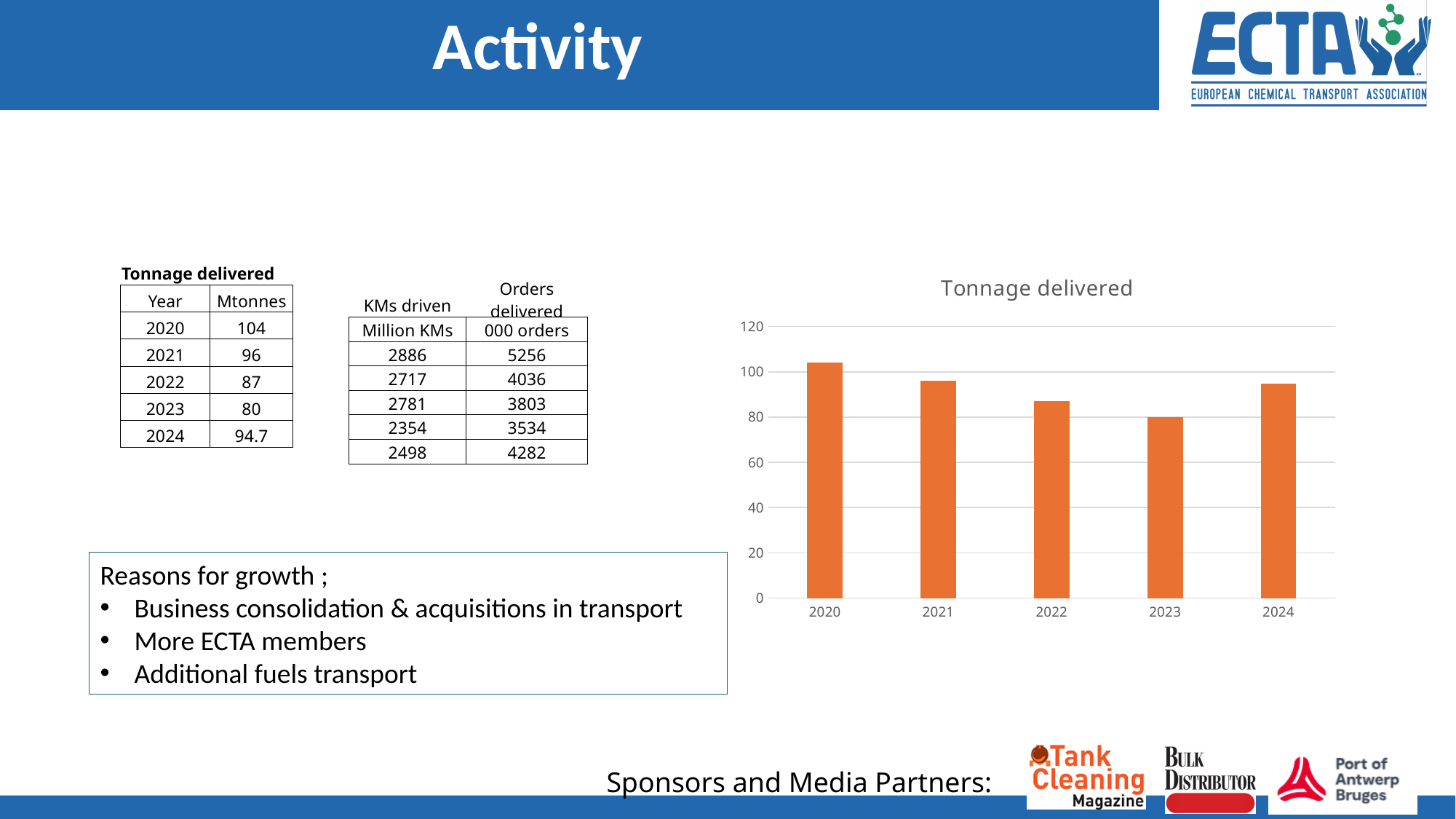
How many years are plotted on the x axis of the chart? 5 Which year has the larger tonnage delivered, 2021 or 2023? 2021 Which year has the larger tonnage delivered, 2022 or 2024? 2024 How does tonnage delivered change from 2020 to 2023 in the chart? falls Is the tonnage delivered for 2020 greater or less than 100? greater Is the tonnage delivered for 2022 greater or less than 100? less What kind of chart is shown on the slide? bar chart Which year has the lowest tonnage delivered in the chart? 2023 Which year has the highest tonnage delivered in the chart? 2020 What colour are the bars in the chart? orange What is the title of the chart? Tonnage delivered Is the tonnage delivered for 2024 greater or less than 80? greater